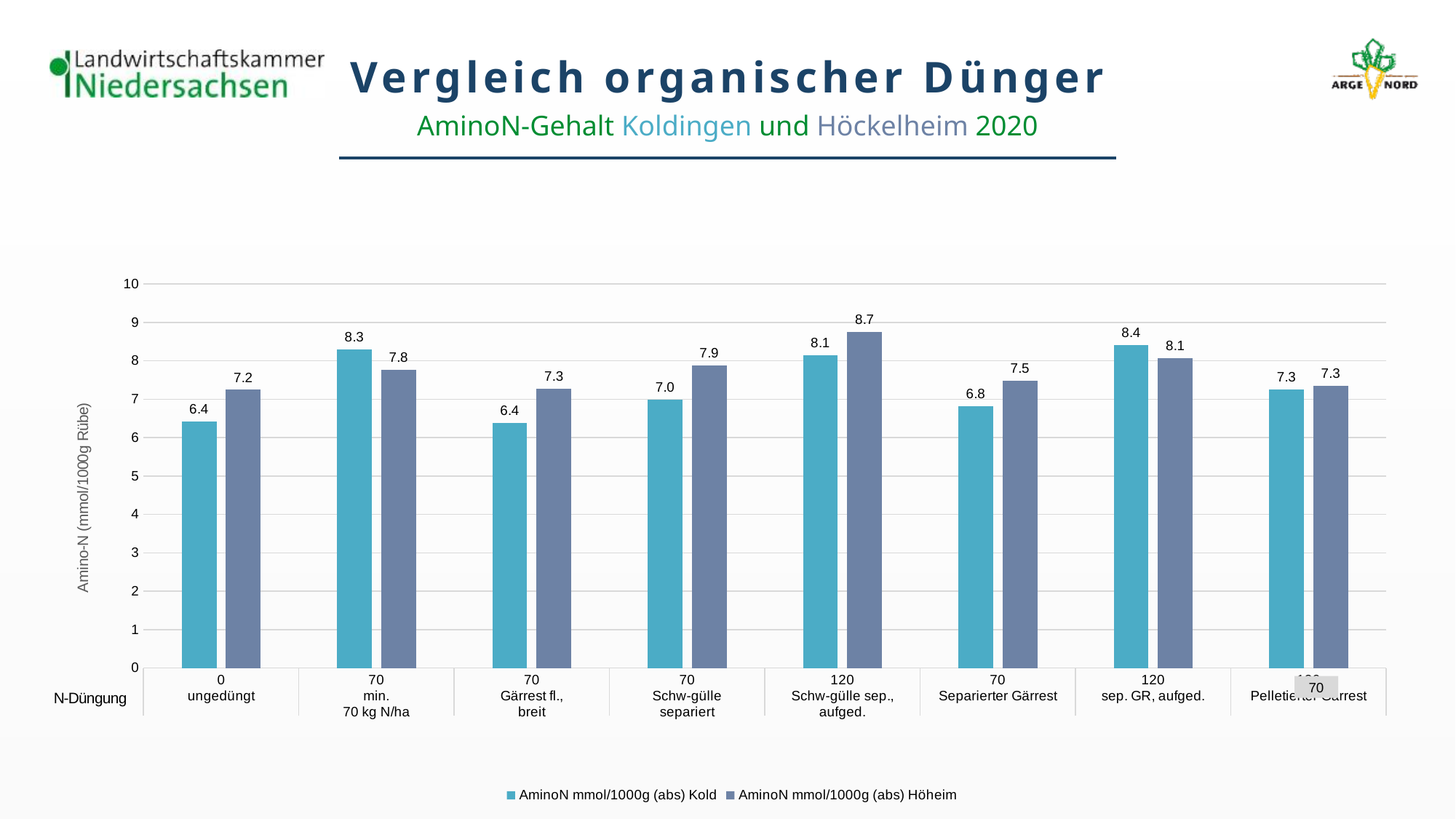
How many series does the legend list? 2 Which category has the highest Höheim value? Schw-gülle sep., aufged. What is the label of the y axis? Amino-N (mmol/1000g Rübe) What is the AminoN value for Kold in the 'ungedüngt' category? 6.4 What is the AminoN value for Kold in the 'sep. GR, aufged.' category? 8.4 What is the difference between the Höheim and Kold values in the 'ungedüngt' category? 0.8 What is the AminoN value for Höheim in the 'Schw-gülle sep., aufged.' category? 8.7 What kind of chart is shown on the slide? bar chart Is the Kold value for 'Separierter Gärrest' greater or less than 7? less How many categories are shown on the x axis? 8 Which category has the lowest Höheim value? ungedüngt Which is larger in the 'min. 70 kg N/ha' category, the Kold value or the Höheim value? Kold